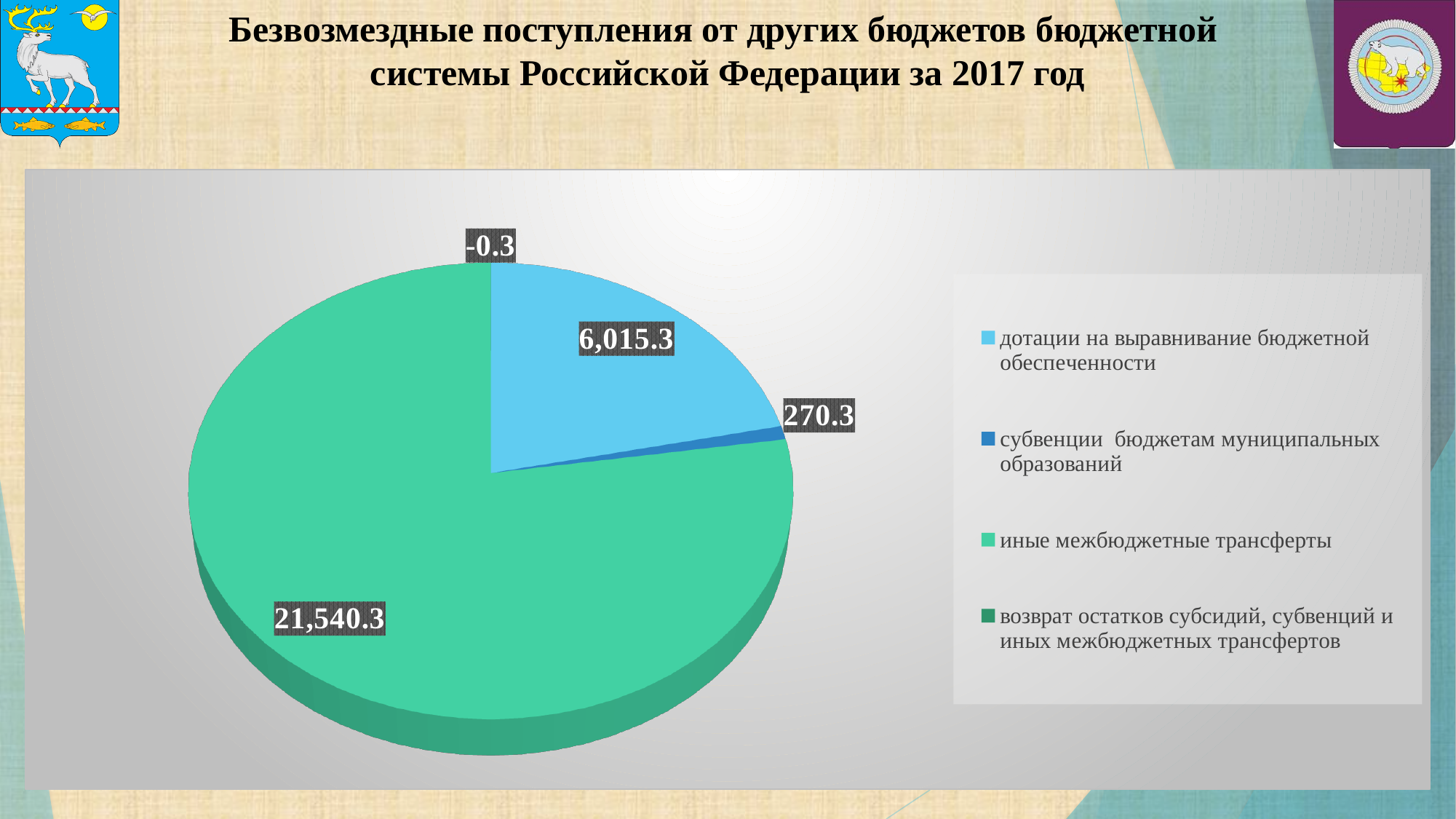
What is the value for субвенции бюджетам муниципальных образований? 270.3 Which is larger: дотации на выравнивание бюджетной обеспеченности or субвенции бюджетам муниципальных образований? дотации на выравнивание бюджетной обеспеченности What is the value for иные межбюджетные трансферты? 21,540.3 What is the value for возврат остатков субсидий, субвенций и иных межбюджетных трансфертов? -0.3 What colour is the slice for иные межбюджетные трансферты? green What is the difference between the values for иные межбюджетные трансферты and дотации на выравнивание бюджетной обеспеченности? 15,525.0 What is the difference between the values for дотации на выравнивание бюджетной обеспеченности and субвенции бюджетам муниципальных образований? 5,745.0 What kind of chart is shown on the slide? pie chart How many categories does the pie chart show? 4 Which category has the largest value? иные межбюджетные трансферты Which category has the smallest value? возврат остатков субсидий, субвенций и иных межбюджетных трансфертов What is the value for дотации на выравнивание бюджетной обеспеченности? 6,015.3